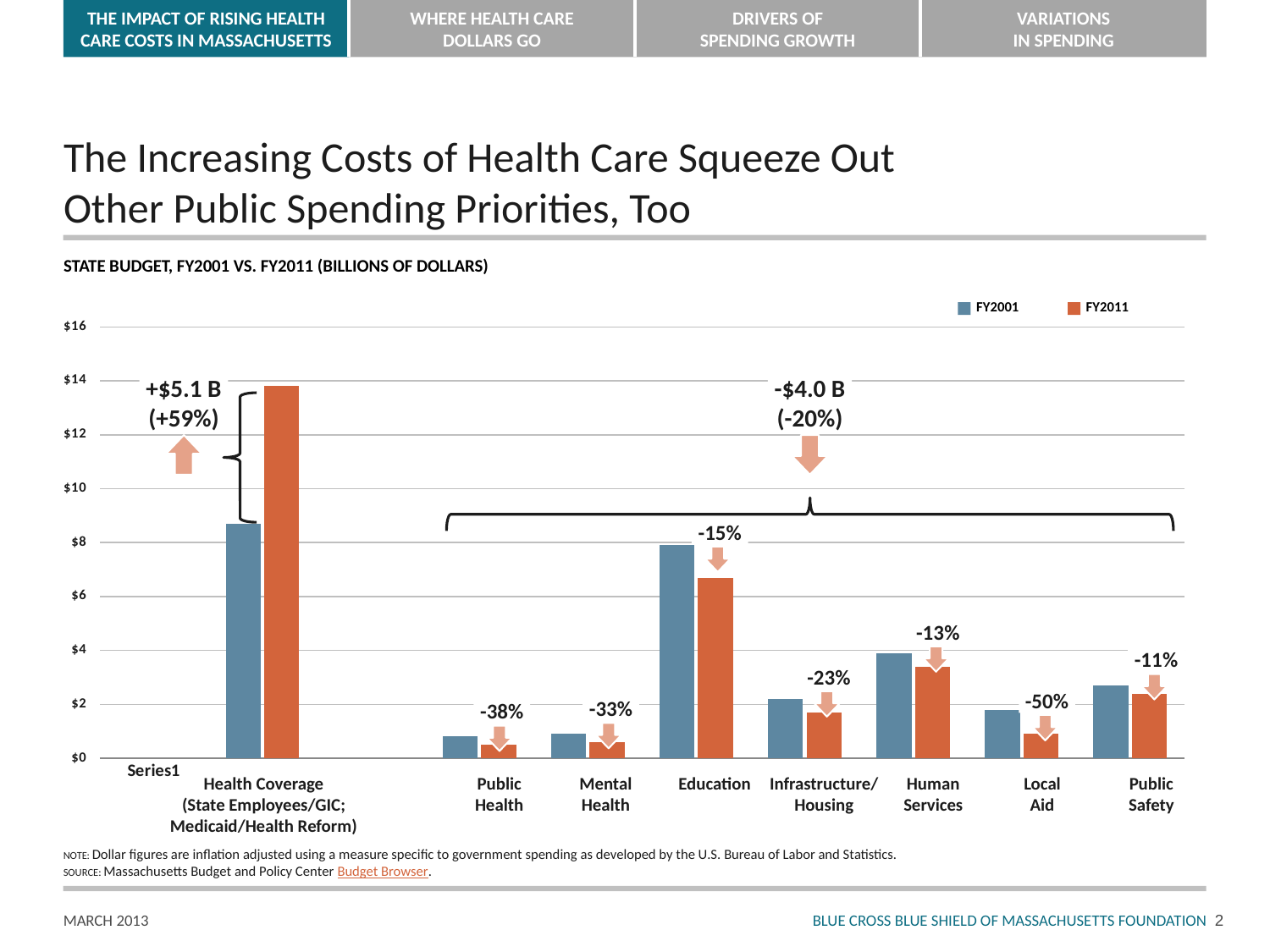
Which category is the only one whose FY2011 bar is higher than its FY2001 bar? Health Coverage Is the FY2011 value for Local Aid greater or less than $2? less What percentage change is labeled for Public Health? -38% Is the FY2011 value for Health Coverage greater or less than $12? greater How many series does the legend list? 2 Which is larger, the FY2001 value for Health Coverage or the FY2001 value for Education? Health Coverage What percentage change is labeled for Local Aid? -50% Which category has the highest FY2011 value? Health Coverage What dollar change is labeled for Health Coverage between FY2001 and FY2011? +$5.1 B Is the FY2001 value for Public Safety greater or less than $2? greater What kind of chart is shown on the slide? bar chart